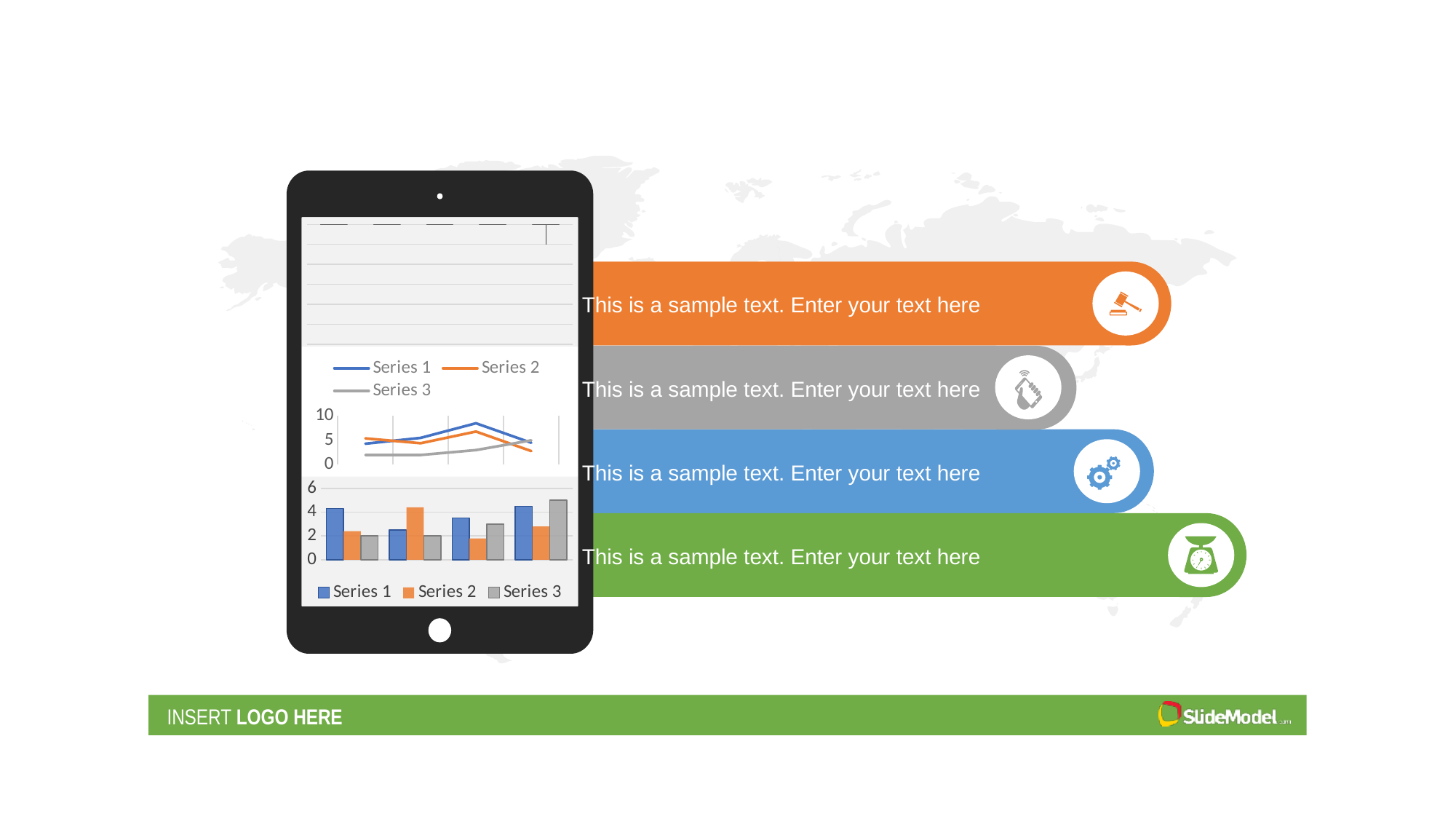
In the upper line chart, is the highest point of Series 1 greater or less than 5? greater In the upper line chart, is the first point of Series 3 greater or less than 5? less In the upper line chart, at the last data point, which is higher: Series 2 or Series 3? Series 3 How many data points does each line have in the upper line chart? 4 What colour represents Series 2 in the lower bar chart's legend? orange How many series does the legend of the lower bar chart list? 3 What kind of chart is the lower chart on the tablet screen? bar chart What kind of chart is the upper chart on the tablet screen? line chart How many series does the legend of the upper line chart list? 3 In the lower bar chart, is the tallest Series 3 bar greater or less than 4? greater In the upper line chart, does Series 3 rise or fall overall from left to right? rises How many groups of bars are there in the lower bar chart? 4